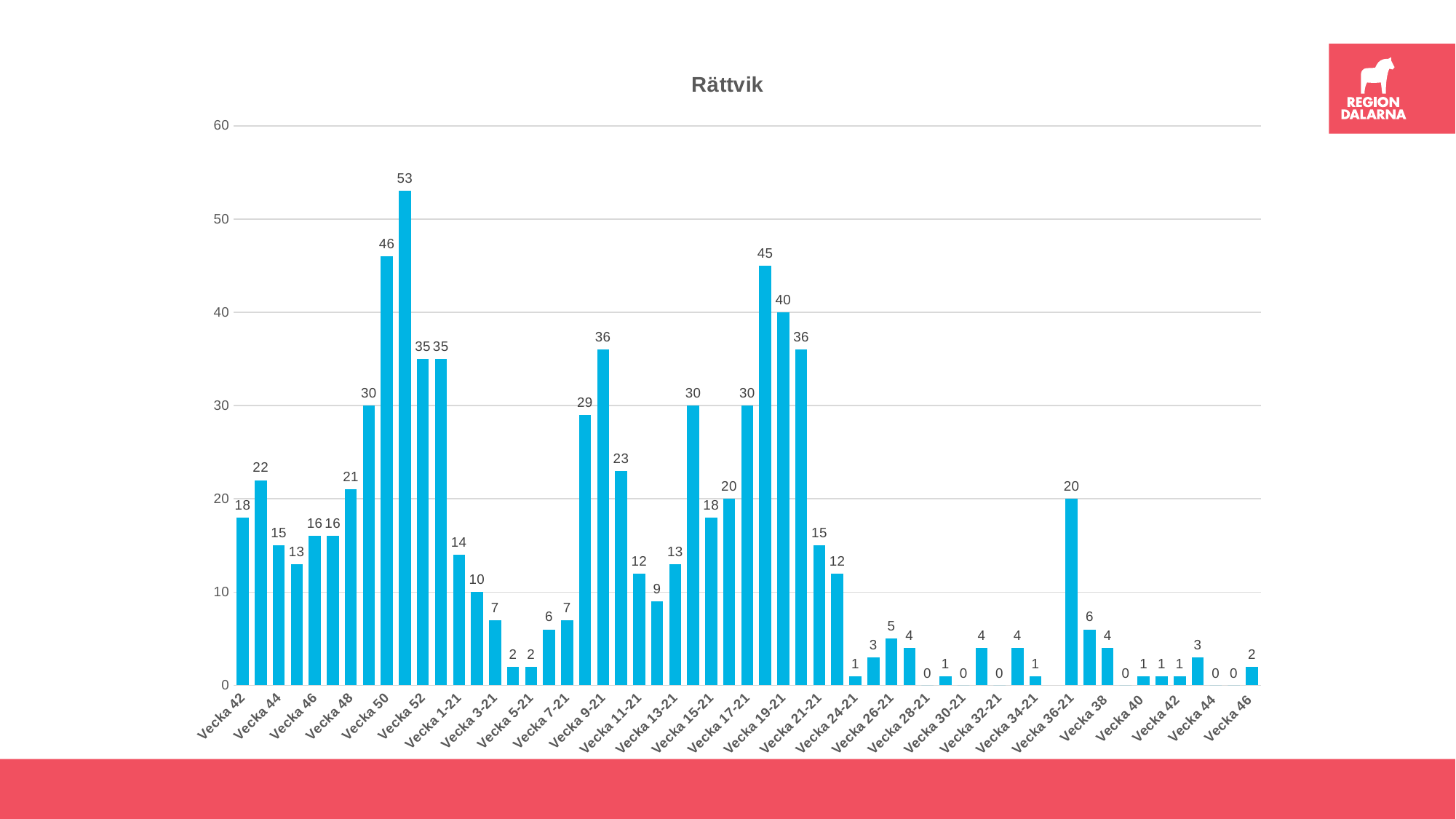
What is the value of the first bar on the left, labelled Vecka 42? 18 What type of chart is shown on the slide? bar chart What is the lowest value shown in the chart? 0 What is the highest value shown in the chart? 53 What is the value for Vecka 19-21? 40 What is the value for Vecka 9-21? 36 What is the difference between the value for Vecka 50 and the value for Vecka 9-21? 10 What is the value for Vecka 36-21? 20 What is the value of the last bar on the right, labelled Vecka 46? 2 Which is larger, the value for Vecka 50 or the value for Vecka 19-21? Vecka 50 What is the title of the chart? Rättvik What is the value for Vecka 50? 46